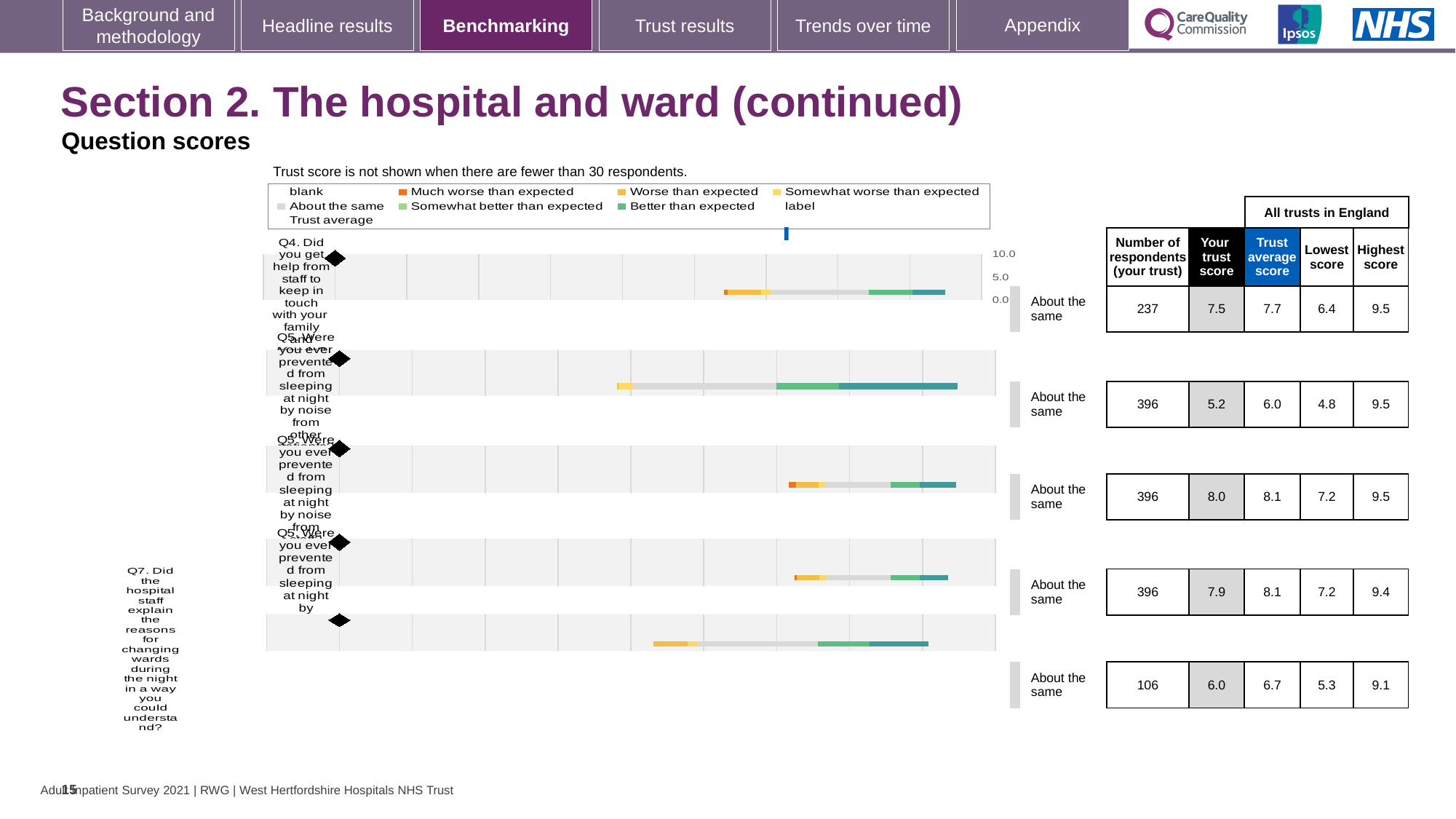
What is the highest score across all trusts in England for Q7? 9.1 What is the 'Your trust score' for Q7 (explaining reasons for changing wards during the night)? 6.0 How many respondents are listed for Q4? 237 What is the 'Your trust score' for Q4 (help from staff to keep in touch with family and friends)? 7.5 Which has the higher 'Your trust score': Q4 or Q7? Q4 How many question rows (bars) are plotted in the chart? 5 What benchmark category label is shown next to every question in the chart? About the same Which question has the lowest number of respondents? Q7 What kind of chart is used to show the question scores on this slide? bar chart For Q7, what is the difference between the trust average score (6.7) and your trust score (6.0)? 0.7 For Q4, how much higher is the trust average score than your trust score? 0.2 What is the lowest 'Your trust score' value shown in the table? 5.2